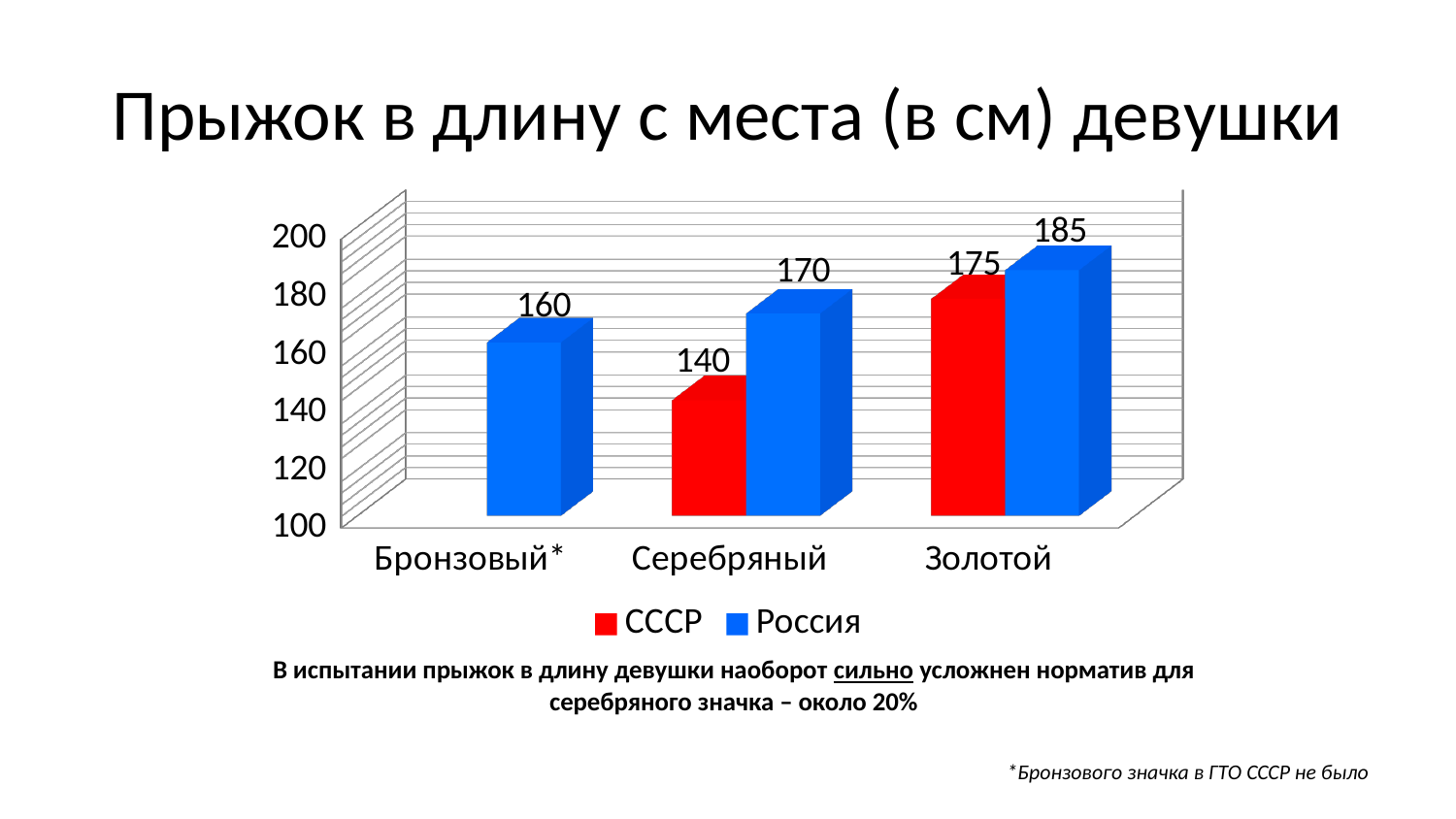
How many series does the legend list? 2 Which category has the highest value for the Россия series? Золотой Which colour represents the СССР series? red Which is larger in the Золотой category: the СССР value or the Россия value? Россия What is the difference between the Россия and СССР values in the Серебряный category? 30 How many categories are shown on the x axis? 3 What is the value for Россия in the Бронзовый* category? 160 What is the value for Россия in the Золотой category? 185 What kind of chart is shown on the slide? bar chart Which category has the lowest value for the Россия series? Бронзовый* What is the value for СССР in the Серебряный category? 140 What is the value for СССР in the Золотой category? 175